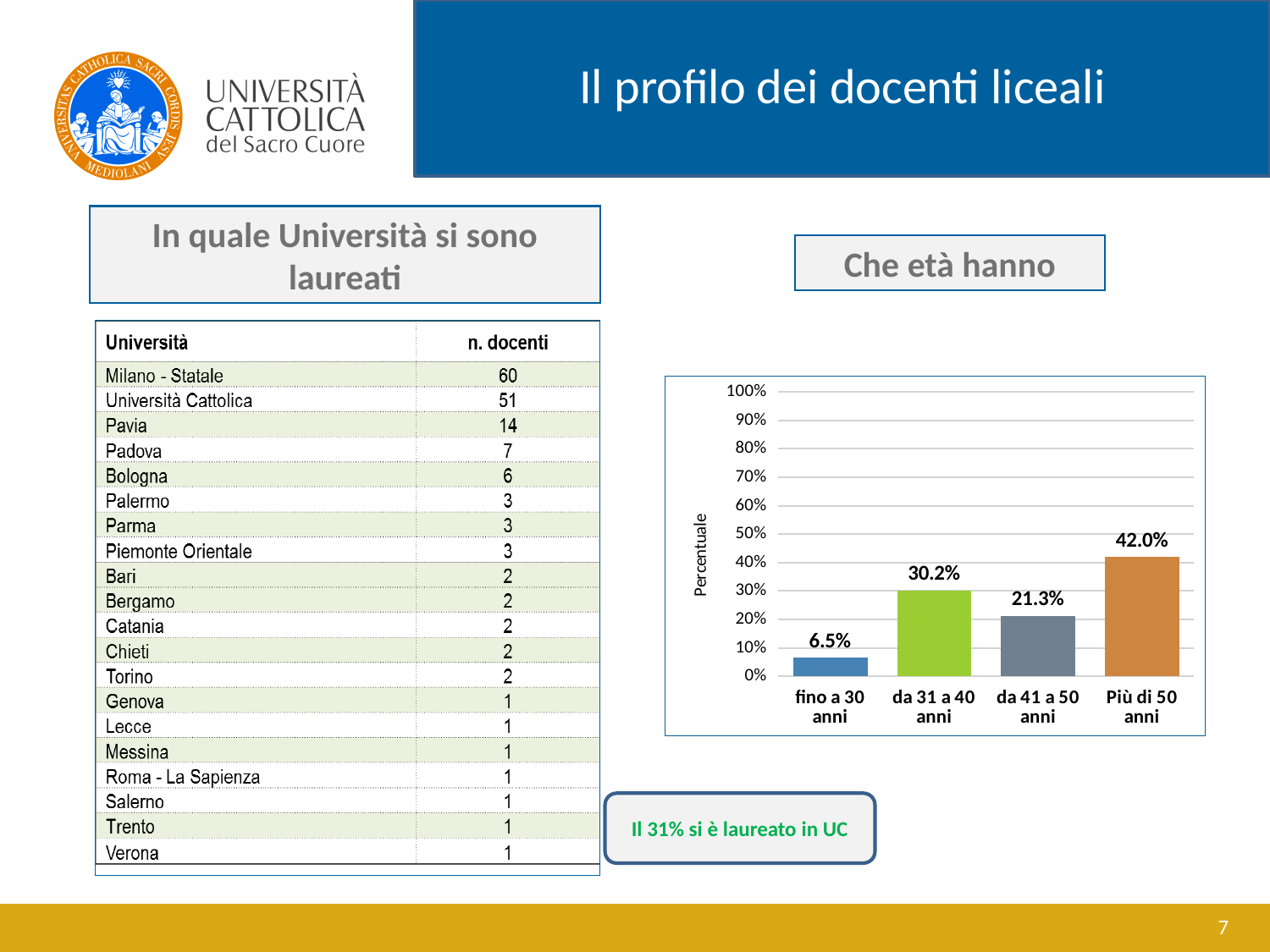
In the "Che età hanno" chart, what is the value for "da 41 a 50 anni"? 21.3% In the "Che età hanno" chart, is the value for "Più di 50 anni" greater or less than 50%? less In the "Che età hanno" chart, what is the difference between the values for "Più di 50 anni" and "da 31 a 40 anni"? 11.8% In the "Che età hanno" chart, what is the value for "Più di 50 anni"? 42.0% In the "Che età hanno" chart, what is the value for "da 31 a 40 anni"? 30.2% In the "Che età hanno" chart, what is the value for "fino a 30 anni"? 6.5% What kind of chart is shown under the heading "Che età hanno"? bar chart How many age groups are shown in the "Che età hanno" chart? 4 In the "Che età hanno" chart, which age group has the lowest percentage? fino a 30 anni In the "Che età hanno" chart, which is larger: the value for "da 31 a 40 anni" or the value for "da 41 a 50 anni"? da 31 a 40 anni What is the label on the vertical axis of the "Che età hanno" chart? Percentuale In the "Che età hanno" chart, which age group has the highest percentage? Più di 50 anni